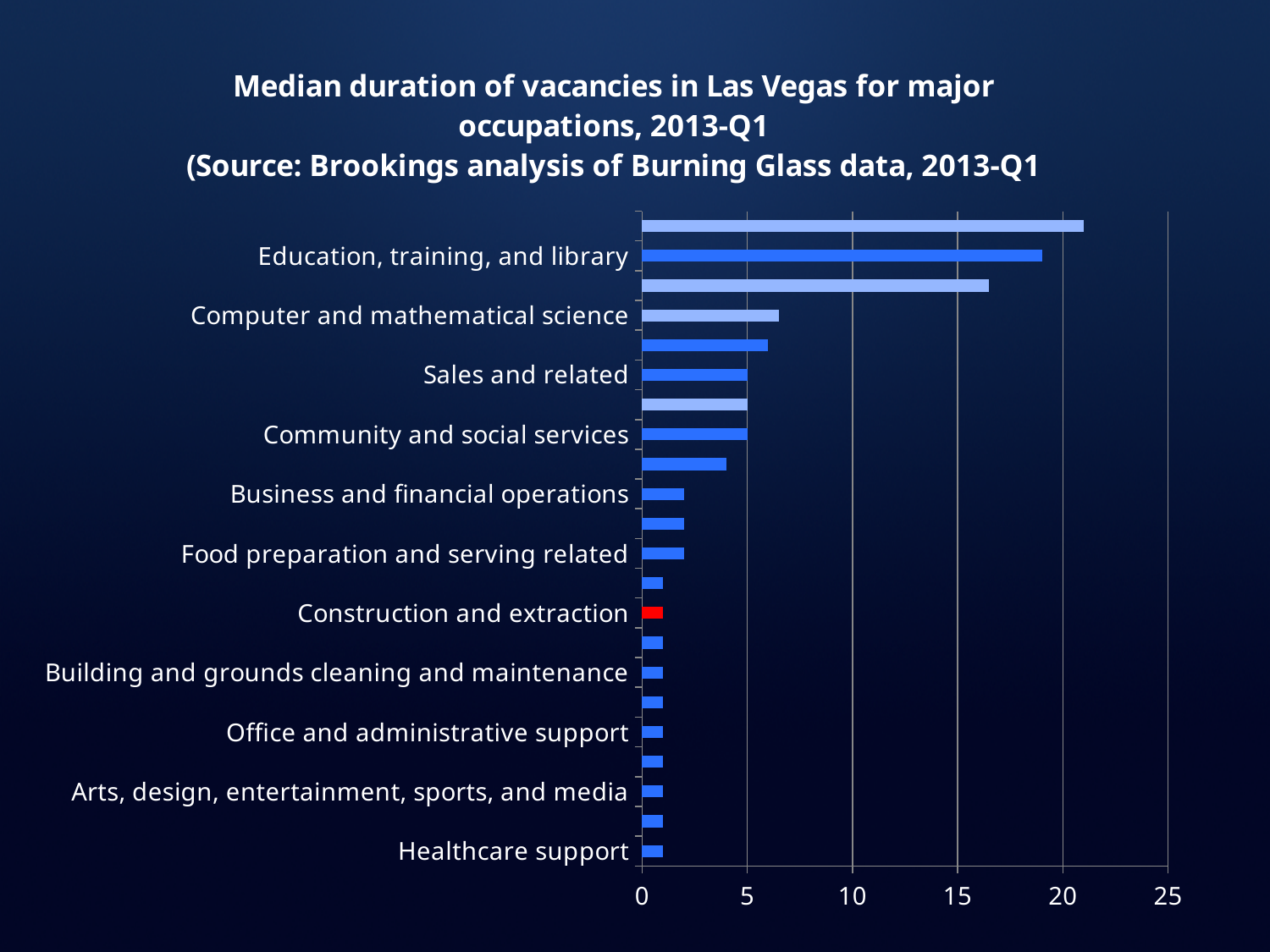
Is the value for Healthcare support greater or less than 5? less What is the highest value shown on the horizontal axis? 25 Is the value for Computer and mathematical science greater or less than 5? greater What kind of chart is shown on the slide? bar chart Is the value for Education, training, and library greater or less than 15? greater Do the bar lengths generally increase or decrease from the top of the chart to the bottom? decrease Which has a longer bar, Education, training, and library or Computer and mathematical science? Education, training, and library Which has a longer bar, Business and financial operations or Construction and extraction? Business and financial operations Which category's bar is coloured red? Construction and extraction